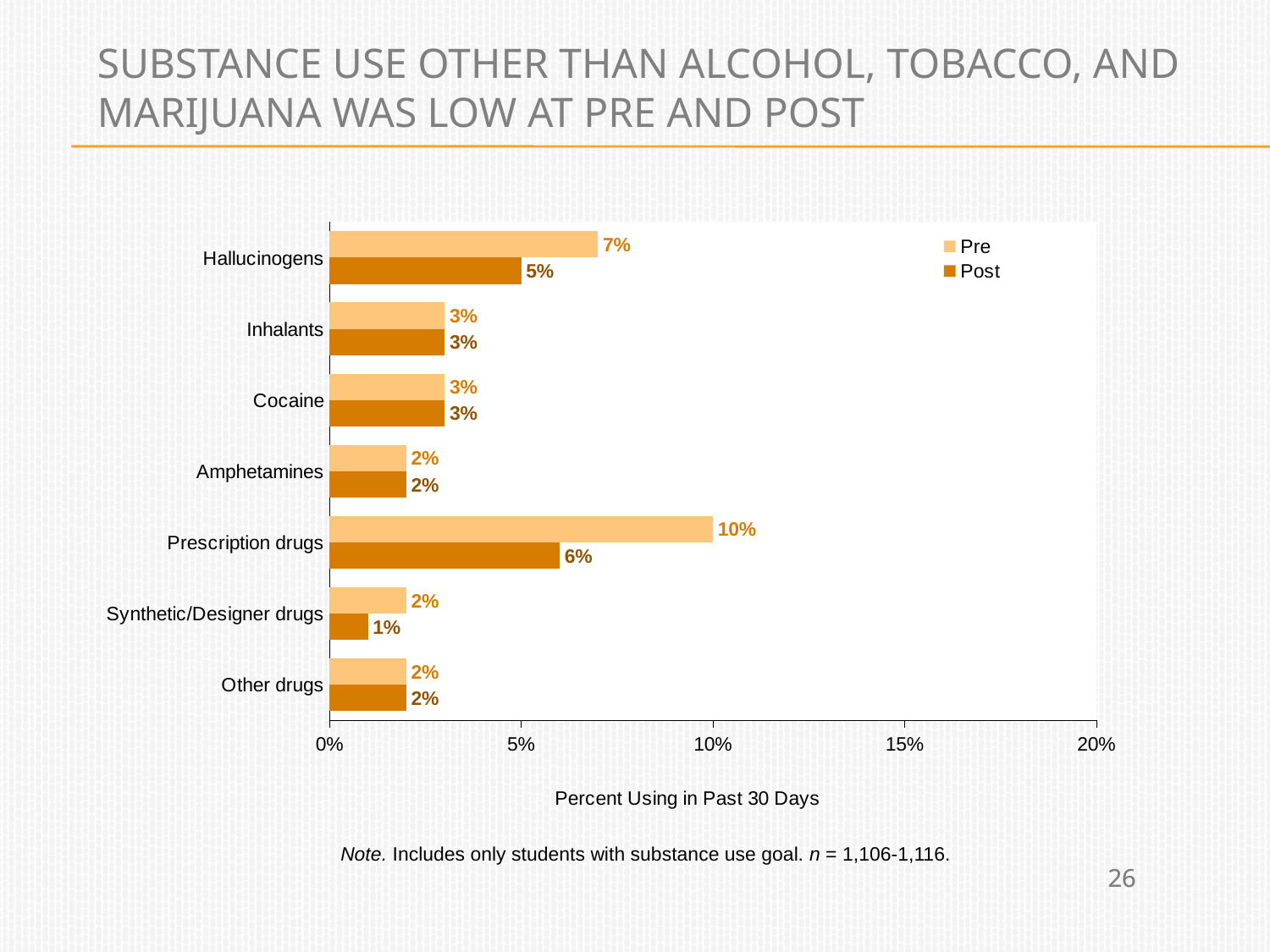
Is the Pre value for Prescription drugs greater or less than 5%? greater What is the Pre value for Prescription drugs? 10% What is the difference between the Pre and Post values for Prescription drugs? 4% What kind of chart is shown on the slide? Bar chart How many substance categories are shown on the chart? 7 What is the difference between the Pre and Post values for Hallucinogens? 2% Which category has the highest Pre value? Prescription drugs What is the Post value for Hallucinogens? 5% What is the Post value for Synthetic/Designer drugs? 1% Which category has the lowest Post value? Synthetic/Designer drugs Which is larger, the Pre value for Hallucinogens or the Post value for Prescription drugs? Pre value for Hallucinogens How many series does the legend list? 2